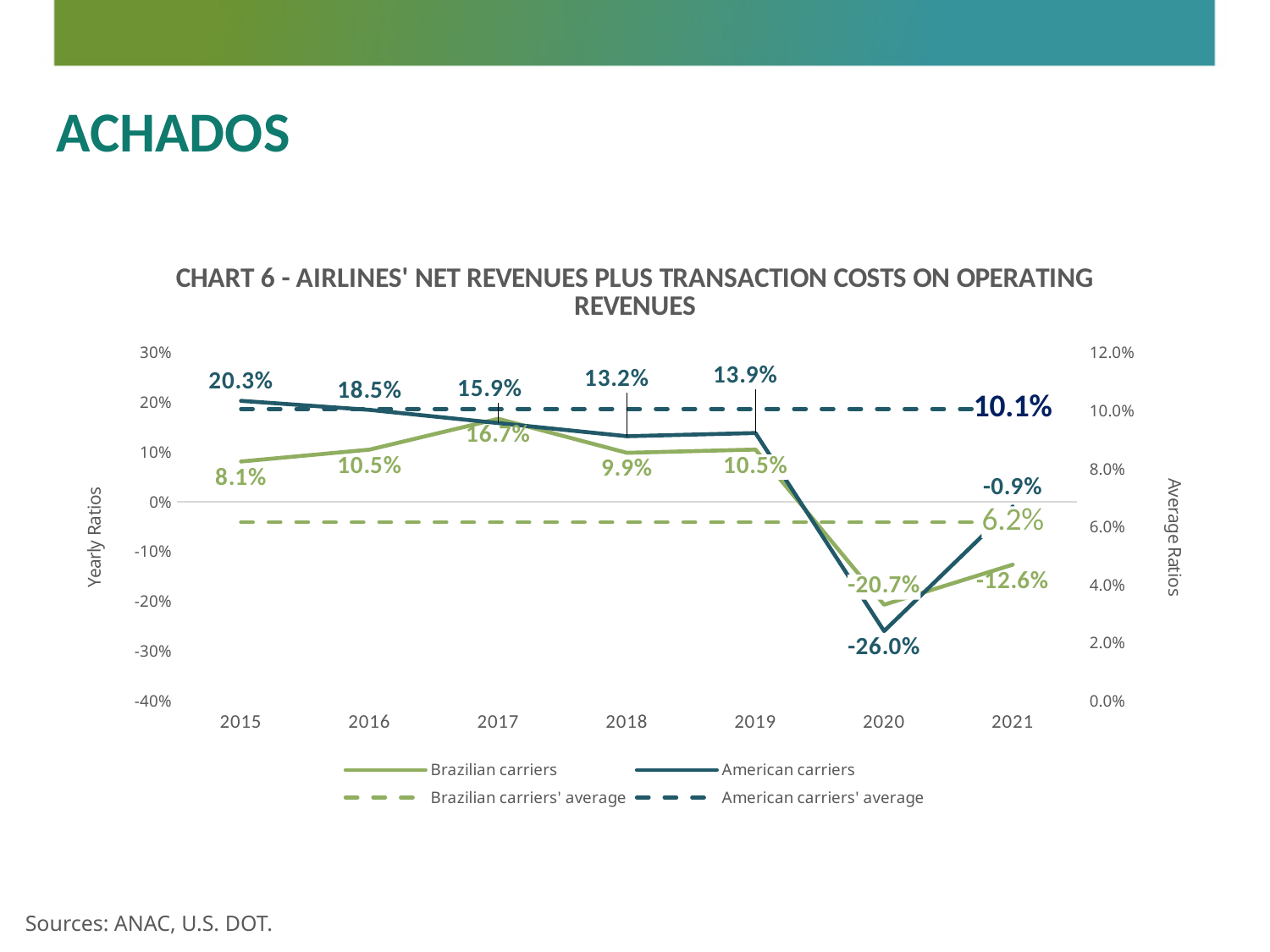
In which year is the value for Brazilian carriers the highest? 2017 Which is larger in 2017, the value for Brazilian carriers or for American carriers? Brazilian carriers What is the value for Brazilian carriers in 2021? -12.6% What kind of chart is this? Line chart What is the value for American carriers in 2020? -26.0% What is the difference between the American carriers' value and the Brazilian carriers' value in 2015? 12.2% In which year is the value for American carriers the lowest? 2020 How many years are shown on the x axis? 7 What is the value for Brazilian carriers in 2017? 16.7% What is the value for American carriers in 2015? 20.3% How many series does the legend list? 4 What is the American carriers' average shown by the dashed line? 10.1%